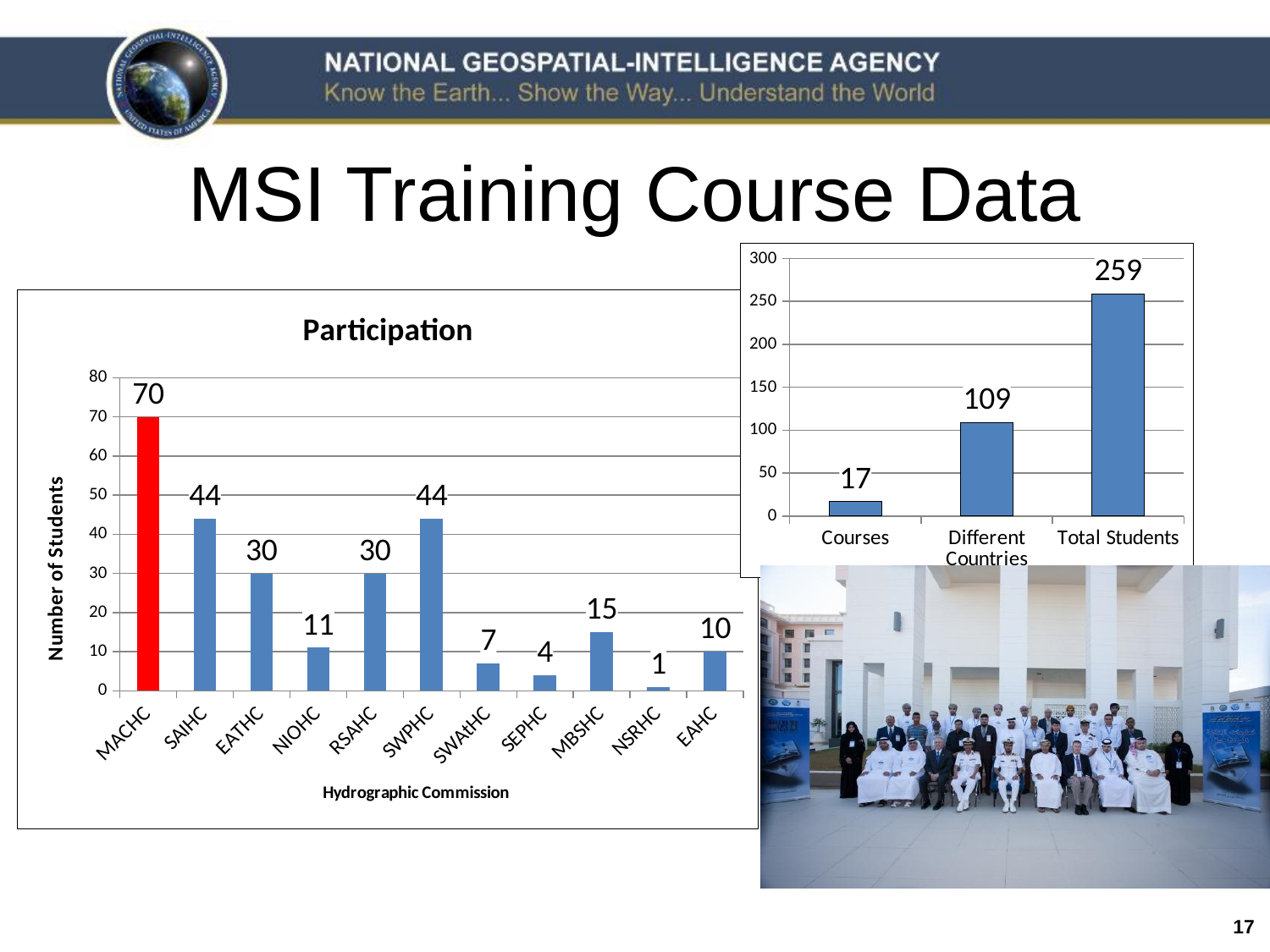
In the chart at the top right, what is the difference between Total Students and Different Countries? 150 In the chart at the top right, what is the value for Different Countries? 109 In the chart at the top right, what is the value for Courses? 17 In the Participation chart, which hydrographic commission has the lowest number of students? NSRHC In the Participation chart, which hydrographic commission has the highest number of students? MACHC In the Participation chart, which has more students, MBSHC or EAHC? MBSHC In the Participation chart, how many hydrographic commissions are shown on the x axis? 11 What kind of chart is the Participation chart? Bar chart In the Participation chart, what is the difference in number of students between MACHC and SAIHC? 26 In the Participation chart, how many students are shown for MACHC? 70 In the Participation chart, how many students are shown for NIOHC? 11 In the Participation chart, what colour is the bar for MACHC? Red